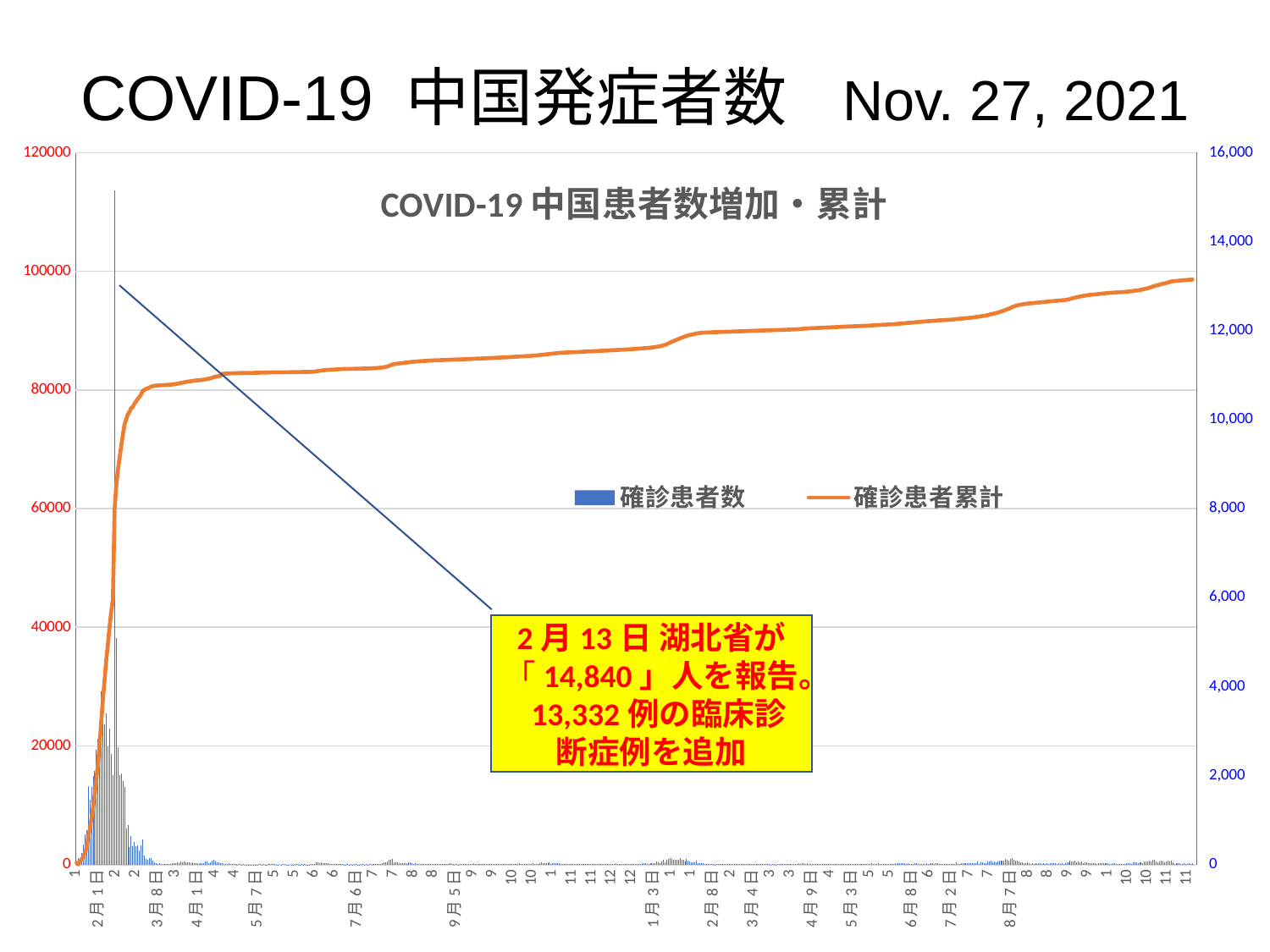
What kind of chart is shown on the slide? A combination bar and line chart What is the maximum value shown on the right vertical axis? 16,000 Which series is plotted as bars, 確診患者数 or 確診患者累計? 確診患者数 Is the value of the 確診患者累計 line at the right end of the chart greater or less than 80000 on the left axis? greater Is the tallest 確診患者数 bar greater or less than 12,000 on the right axis? greater What is the maximum value shown on the left vertical axis? 120000 What is the title of the chart? COVID-19 中国患者数増加・累計 Does the 確診患者累計 line rise or fall along the x axis overall? Rise According to the annotation box, how many 臨床診断症例 were added? 13,332 How many series does the chart legend list? 2 Is the value of the 確診患者累計 line at the left end of the chart greater or less than 20000 on the left axis? less According to the annotation box, how many people did 湖北省 report on 2月13日? 14,840